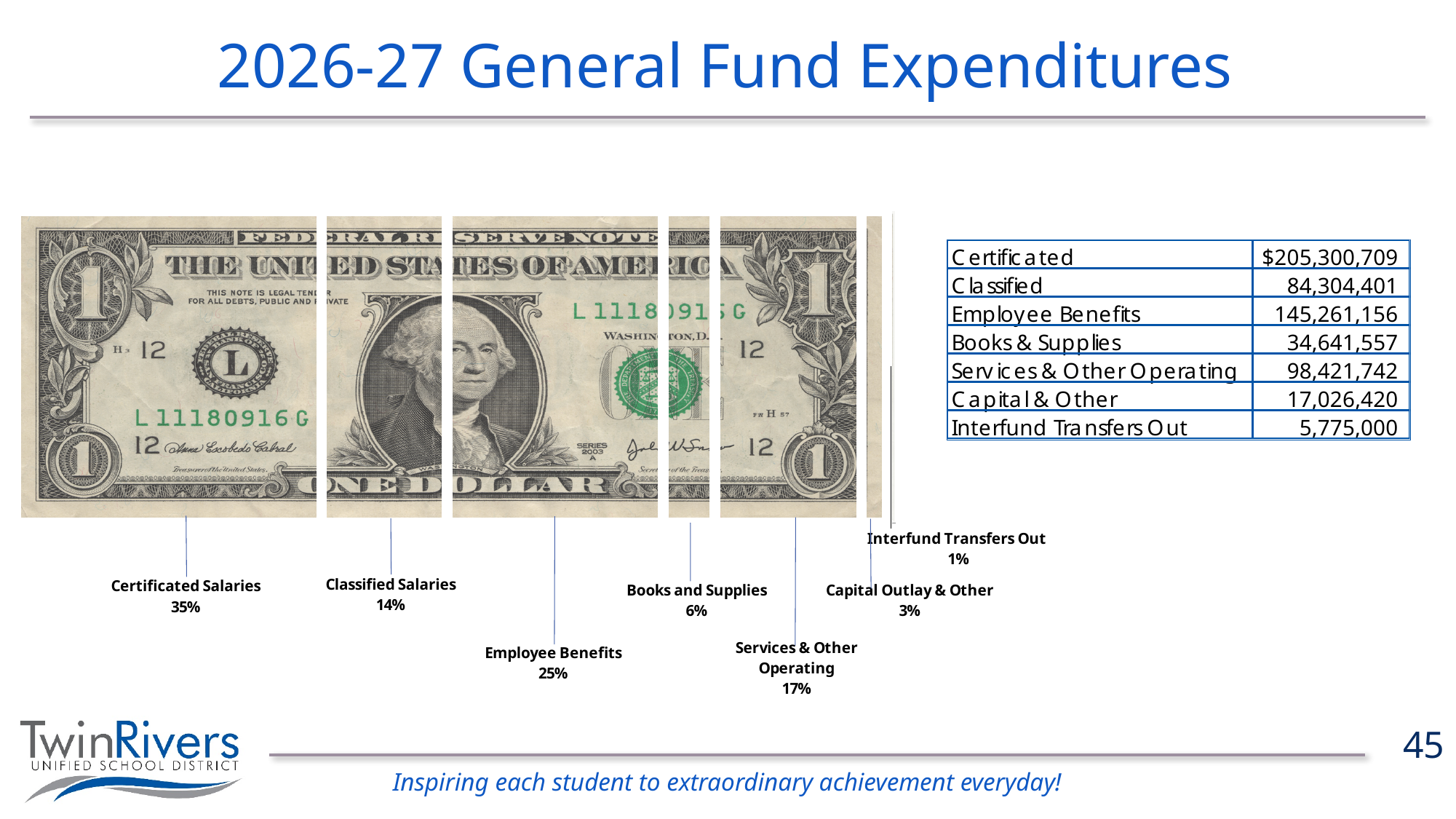
What percentage of expenditures is shown for Employee Benefits? 25% What is the difference in percentage points between Certificated Salaries and Classified Salaries? 21 percentage points How many expenditure categories are shown on the dollar bill? 7 According to the table, what is the dollar amount for Certificated? $205,300,709 Which expenditure category has the largest share of the dollar? Certificated Salaries According to the table, what is the dollar amount for Employee Benefits? 145,261,156 Which expenditure category has the smallest share of the dollar? Interfund Transfers Out Which has a larger share, Employee Benefits or Services & Other Operating? Employee Benefits What percentage is shown for Services & Other Operating? 17% What percentage is shown for Interfund Transfers Out? 1% What percentage of 2026-27 General Fund Expenditures goes to Certificated Salaries? 35% What image is used to represent the breakdown of expenditures on this slide? A one dollar bill cut into segments